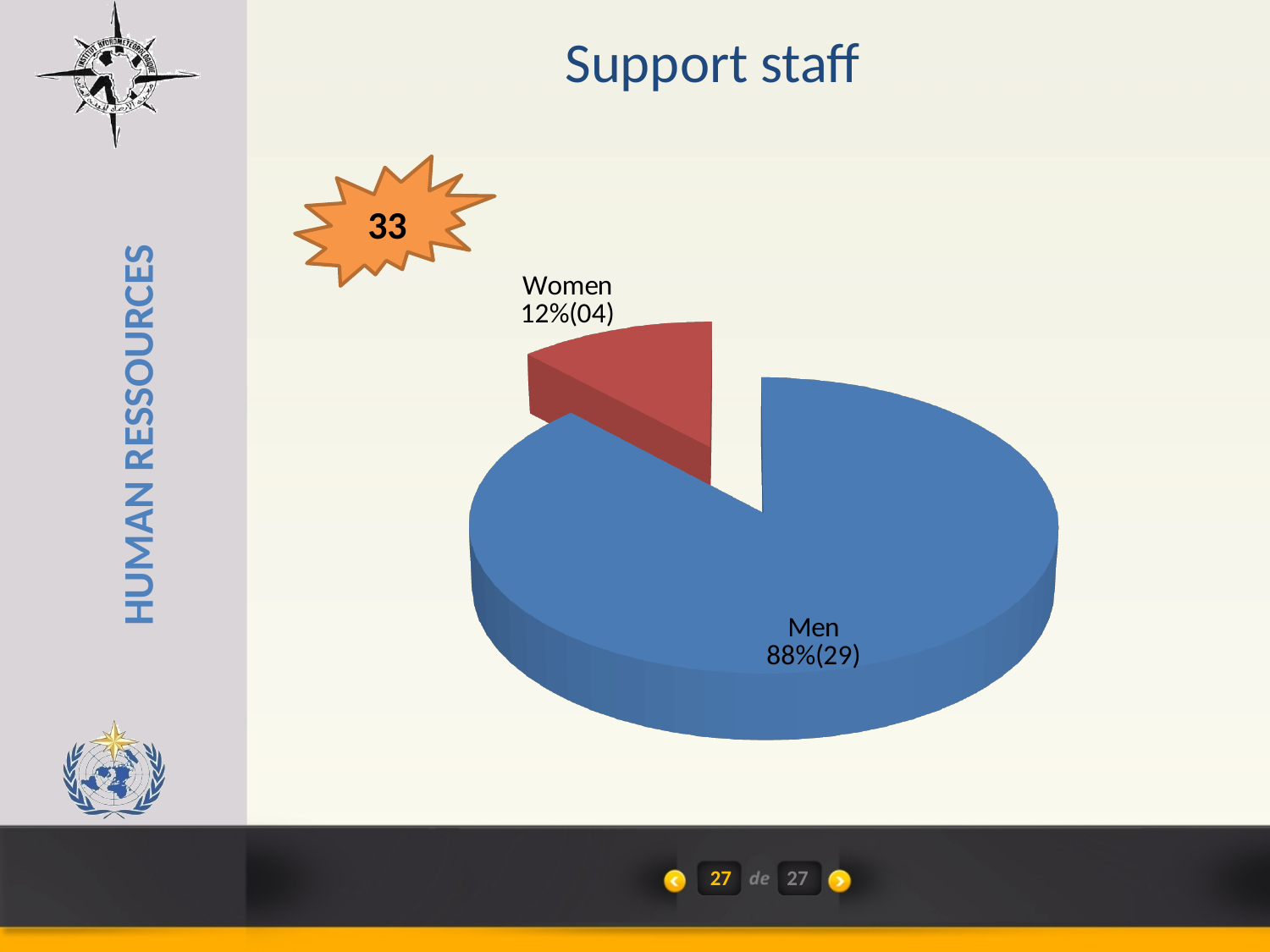
Which is larger, the Men slice or the Women slice? Men Which category has the largest share of the pie? Men What percentage of support staff are women? 12% How many women are in the support staff according to the chart label? 04 Which category has the smallest share of the pie? Women How many men are in the support staff according to the chart label? 29 What kind of chart is shown on the slide? pie chart How many slices does the pie chart have? 2 What number is shown in the orange starburst shape next to the chart? 33 What is the difference in percentage points between the Men and Women slices? 76 What is the title of the slide containing the chart? Support staff What percentage of support staff are men? 88%